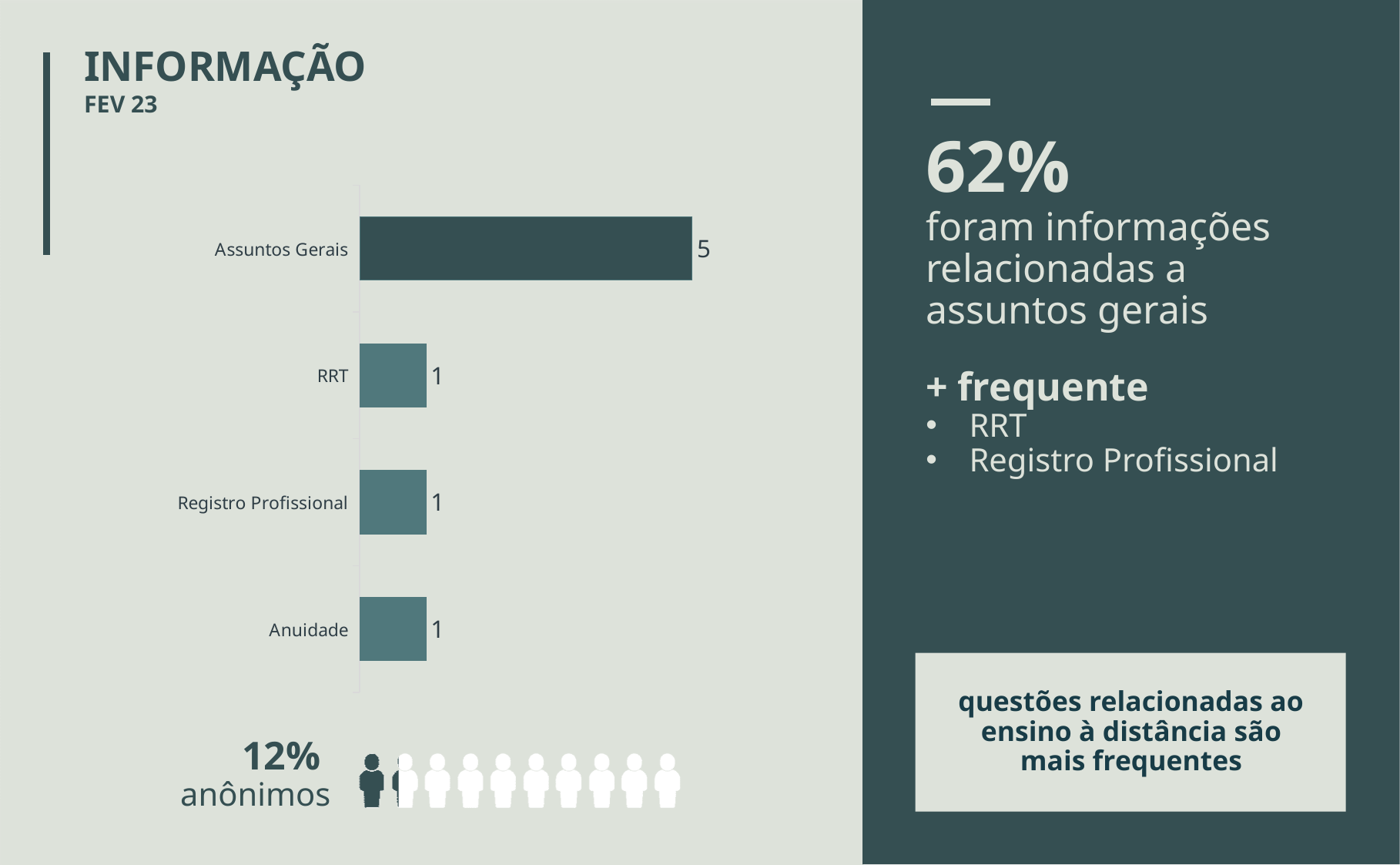
Which category is listed at the top of the chart? Assuntos Gerais What is the value for Anuidade? 1 How many categories are shown in the chart? 4 What is the total of all the values shown in the chart? 8 Which is larger, the value for Assuntos Gerais or the value for Anuidade? Assuntos Gerais Which category's bar is a darker colour than the others? Assuntos Gerais What is the difference between the values for Assuntos Gerais and RRT? 4 What is the value for Assuntos Gerais? 5 What is the value for RRT? 1 Which category has the highest value? Assuntos Gerais What kind of chart is shown on the slide? bar chart What is the value for Registro Profissional? 1